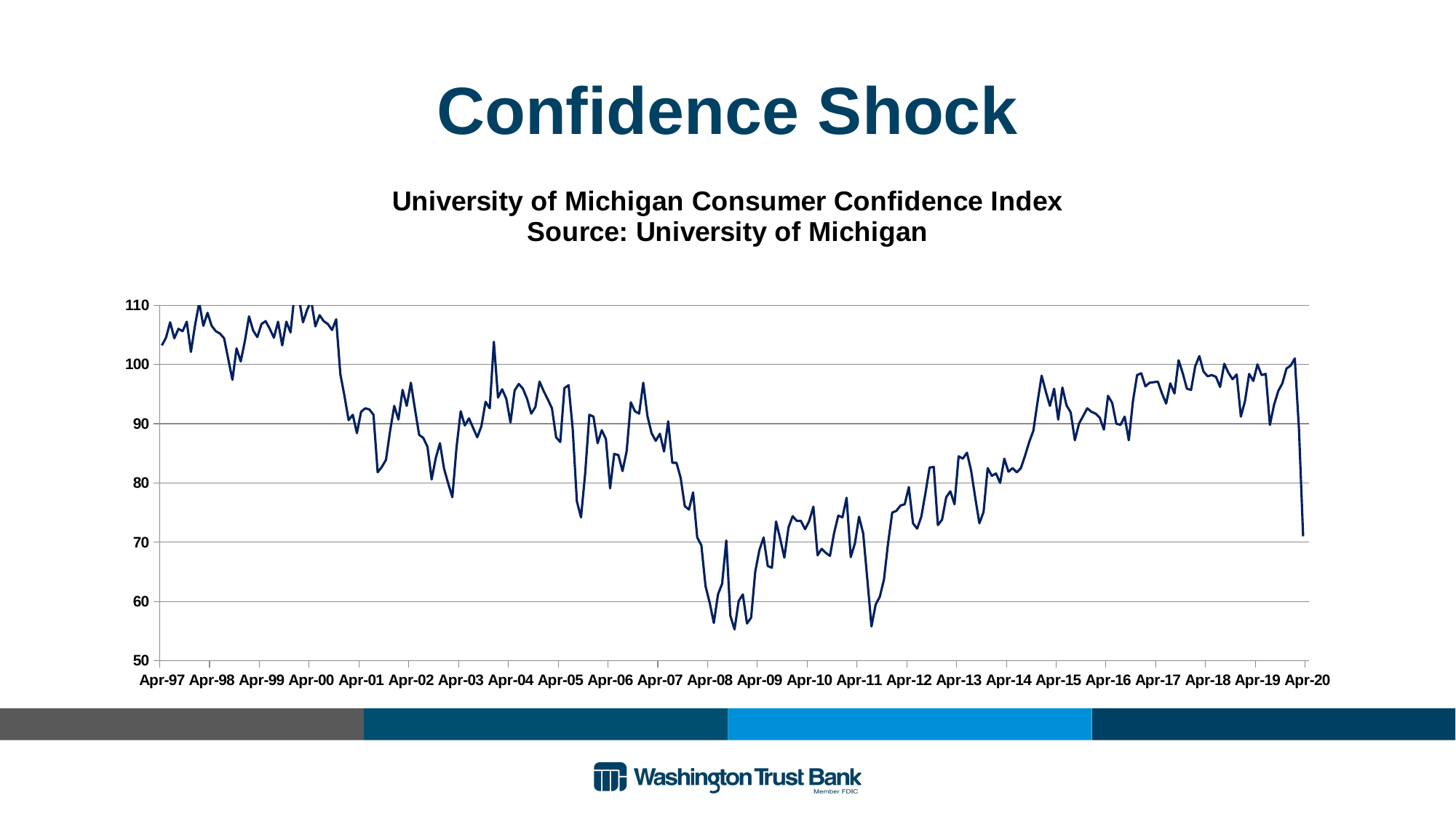
What is the title of the chart? University of Michigan Consumer Confidence Index How many x-axis labels are shown on the chart? 24 Is the value at Apr-97 greater or less than 100? greater Is the value at Apr-10 greater or less than 80? less Does the line rise or fall between Apr-19 and Apr-20? fall Around which x-axis label does the line reach its highest value? Apr-00 Is the value at Apr-20 greater or less than 80? less How many data series are plotted on the chart? 1 What source is cited for the chart data? University of Michigan What kind of chart is shown on the slide? line chart Which is higher, the value at Apr-00 or the value at Apr-10? Apr-00